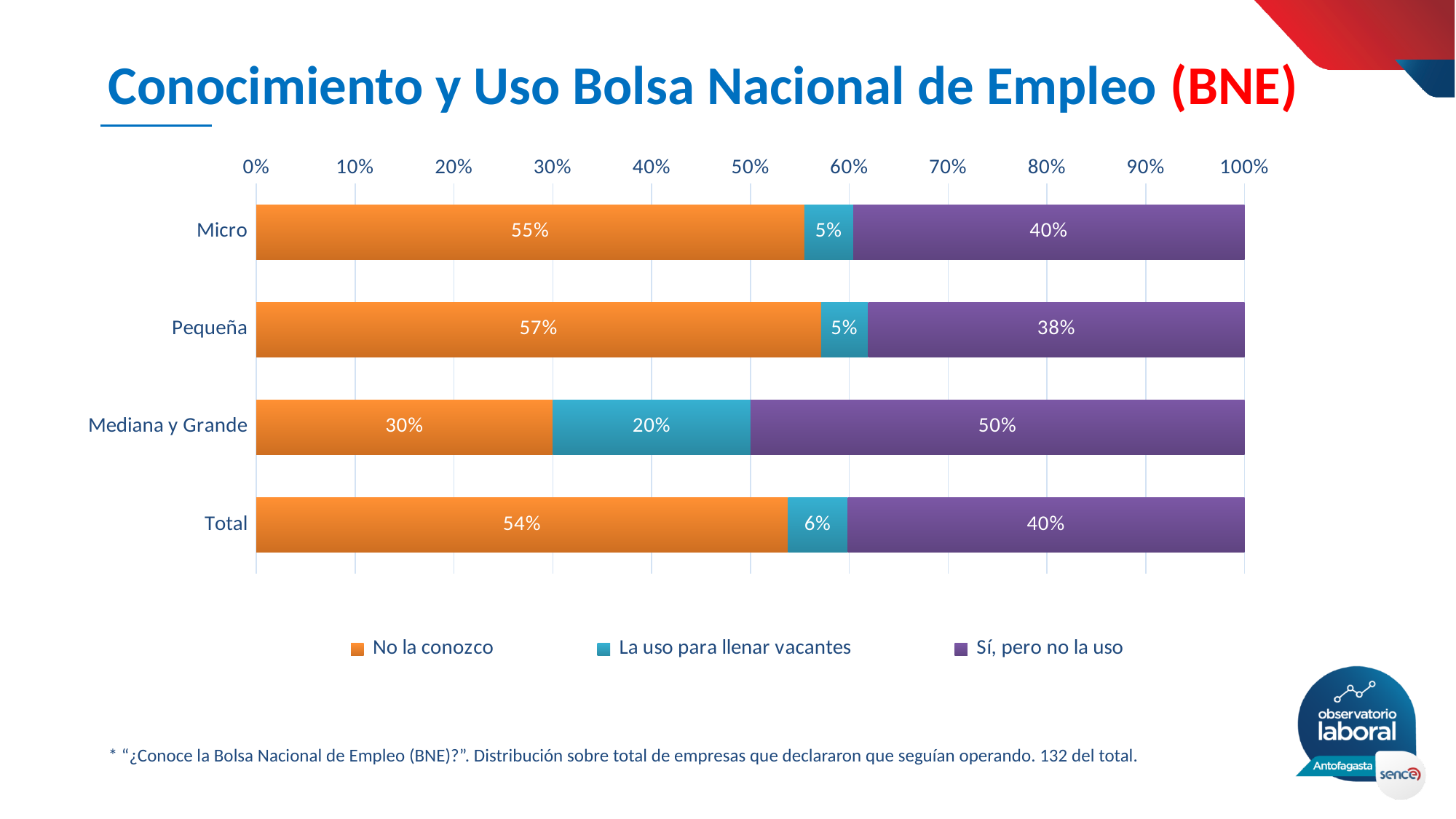
Which colour represents "La uso para llenar vacantes" in the chart? Blue Which is larger: the "No la conozco" value for Micro or for Pequeña? Pequeña What kind of chart is shown on the slide? Stacked bar chart How many series does the legend list? 3 What is the value for "La uso para llenar vacantes" in the Total category? 6% What percentage of Micro companies answered "No la conozco"? 55% Which category has the highest value for "Sí, pero no la uso"? Mediana y Grande Which category has the lowest value for "No la conozco"? Mediana y Grande What is the difference between the "No la conozco" values for Pequeña and Mediana y Grande? 27% What is the value for "La uso para llenar vacantes" in the Mediana y Grande category? 20% How many categories are shown on the chart? 4 What is the value for "Sí, pero no la uso" in the Pequeña category? 38%